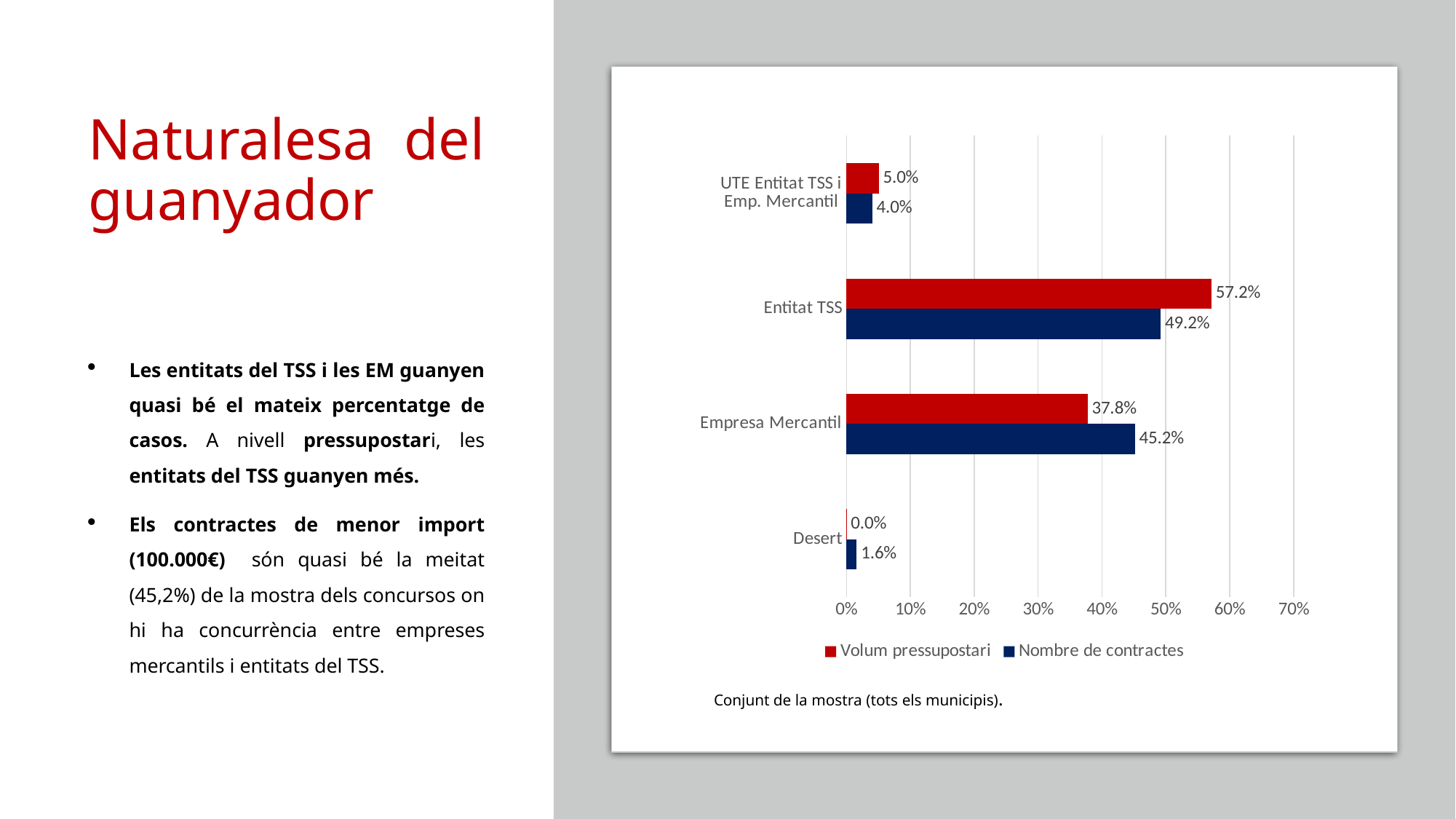
Which category has the highest Volum pressupostari value? Entitat TSS What is the Volum pressupostari value for UTE Entitat TSS i Emp. Mercantil? 5.0% Which colour represents the Nombre de contractes series? Dark blue What kind of chart is shown on the slide? Bar chart Which category has the lowest Nombre de contractes value? Desert How many series does the legend list? 2 For Empresa Mercantil, which is larger: Volum pressupostari or Nombre de contractes? Nombre de contractes What is the Nombre de contractes value for Desert? 1.6% What is the Nombre de contractes value for Empresa Mercantil? 45.2% What is the difference between the Volum pressupostari and Nombre de contractes values for Entitat TSS? 8.0% What is the Volum pressupostari value for Entitat TSS? 57.2% How many categories are shown on the chart? 4